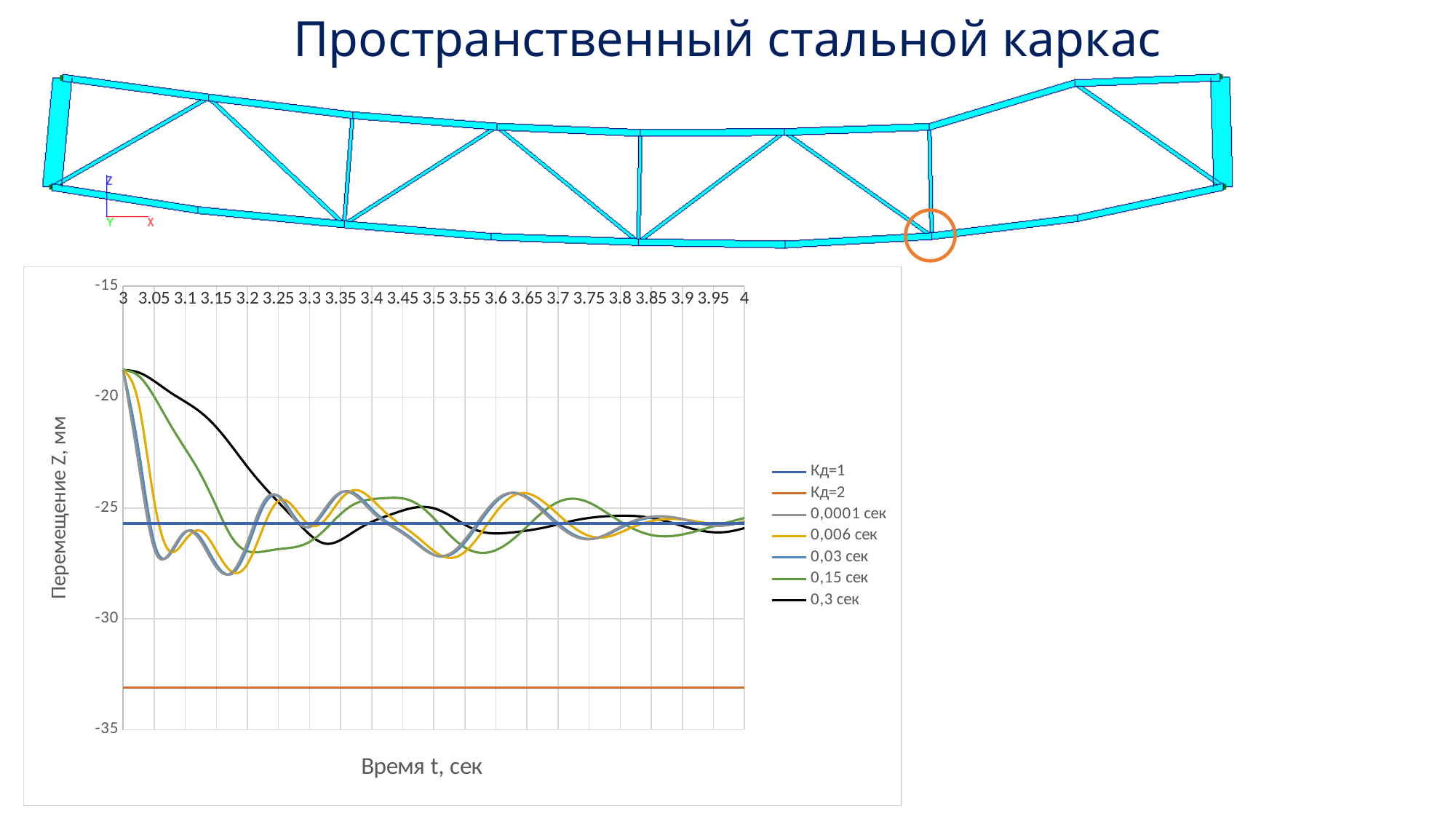
Does the 0,3 сек curve rise or fall between t = 3 and t = 3.3? fall Which is higher on the chart, the Кд=1 line or the Кд=2 line? Кд=1 Which series in the chart has the lowest (most negative) displacement value? Кд=2 What kind of chart is shown on the slide? line chart How many series does the chart legend list? 7 Which two series in the chart are plotted as horizontal straight lines? Кд=1 and Кд=2 Is the Кд=1 line in the chart above or below the -30 gridline? above What is the title of the y axis of the chart? Перемещение Z, мм Is the Кд=2 line in the chart above or below the -30 gridline? below At t = 3, is the 0,3 сек curve above or below the -20 gridline? above How many tick labels are shown on the x axis of the chart? 21 What is the title of the x axis of the chart? Время t, сек